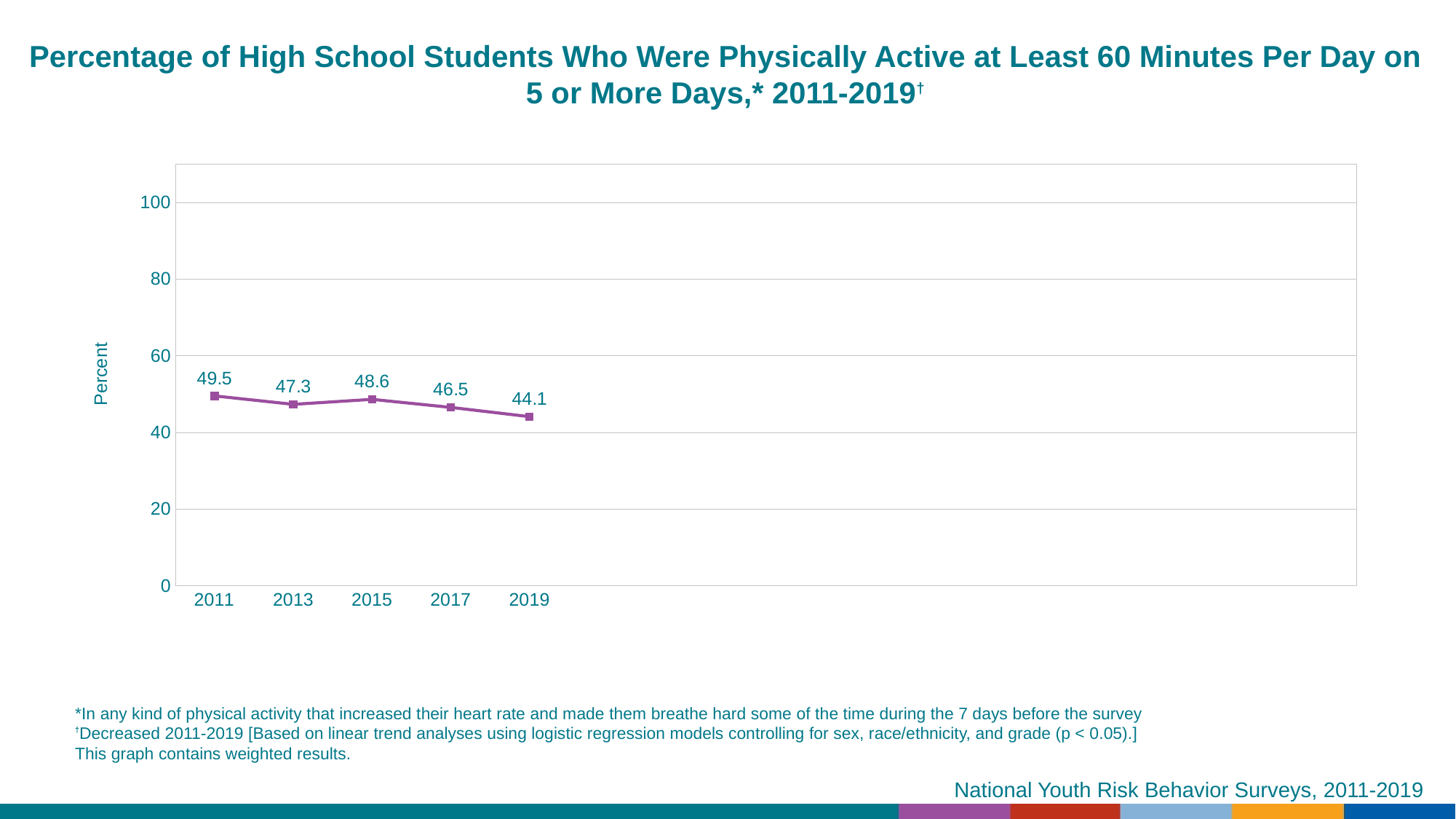
Do the values generally rise or fall from 2011 to 2019? fall What kind of chart is shown on the slide? line chart Which year has the larger value, 2013 or 2015? 2015 Is the value for 2017 greater or less than 60? less What is the label on the vertical axis? Percent What is the difference between the 2011 value and the 2019 value? 5.4 Which year has the highest value on the chart? 2011 Which year has the lowest value on the chart? 2019 What was the percentage of high school students who were physically active at least 60 minutes per day on 5 or more days in 2011? 49.5 How many years are plotted on the chart? 5 What value is shown for 2019? 44.1 What value is shown for 2015? 48.6